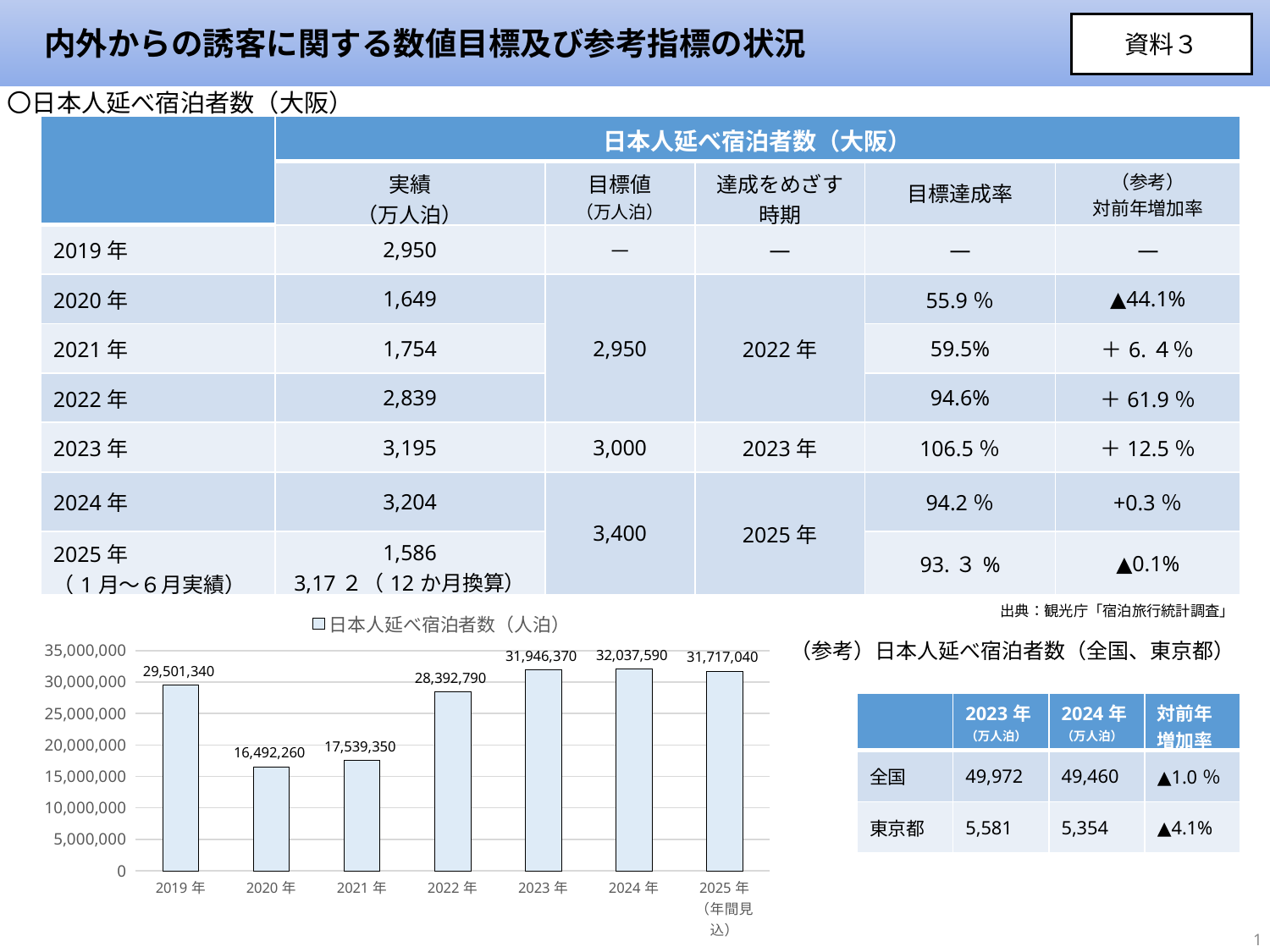
What is the legend entry shown above the bar chart? 日本人延べ宿泊者数（人泊） In the bar chart, which is larger, the value for 2021年 or the value for 2022年? 2022年 What is the value for 2025年（年間見込） in the bar chart? 31,717,040 Which year has the lowest value in the bar chart? 2020年 What is the difference between the values for 2019年 and 2020年 in the bar chart? 13,009,080 Which year has the highest value in the bar chart? 2024年 What is the difference between the values for 2024年 and 2023年 in the bar chart? 91,220 What is the value for 2019年 in the bar chart? 29,501,340 How many years are shown on the x axis of the bar chart? 7 What kind of chart is shown on the slide? bar chart Is the value for 2021年 in the bar chart greater or less than 20,000,000? less What is the value for 2022年 in the bar chart? 28,392,790